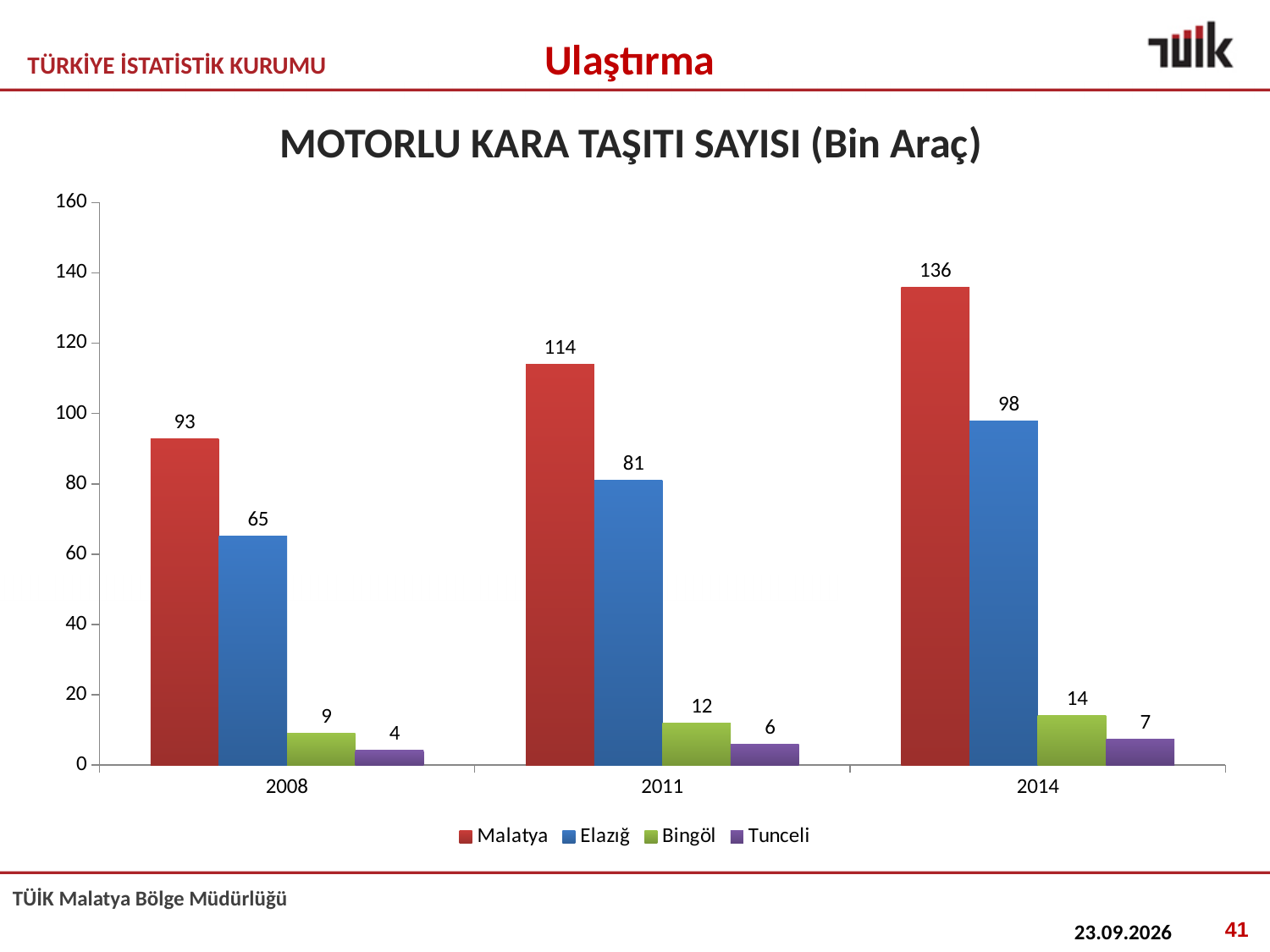
What is the value for Tunceli in 2014? 7 How many years are shown on the x axis? 3 Which province has the lowest value in 2008? Tunceli Do the values for Malatya rise or fall from 2008 to 2014? Rise What is the value for Malatya in 2014? 136 Which province has the highest value in 2011? Malatya What kind of chart is shown on the slide? Bar chart What is the value for Bingöl in 2011? 12 Which is larger, Elazığ in 2011 or Malatya in 2008? Malatya in 2008 What is the difference between Malatya and Elazığ in 2014? 38 How many series does the legend list? 4 What is the value for Elazığ in 2008? 65